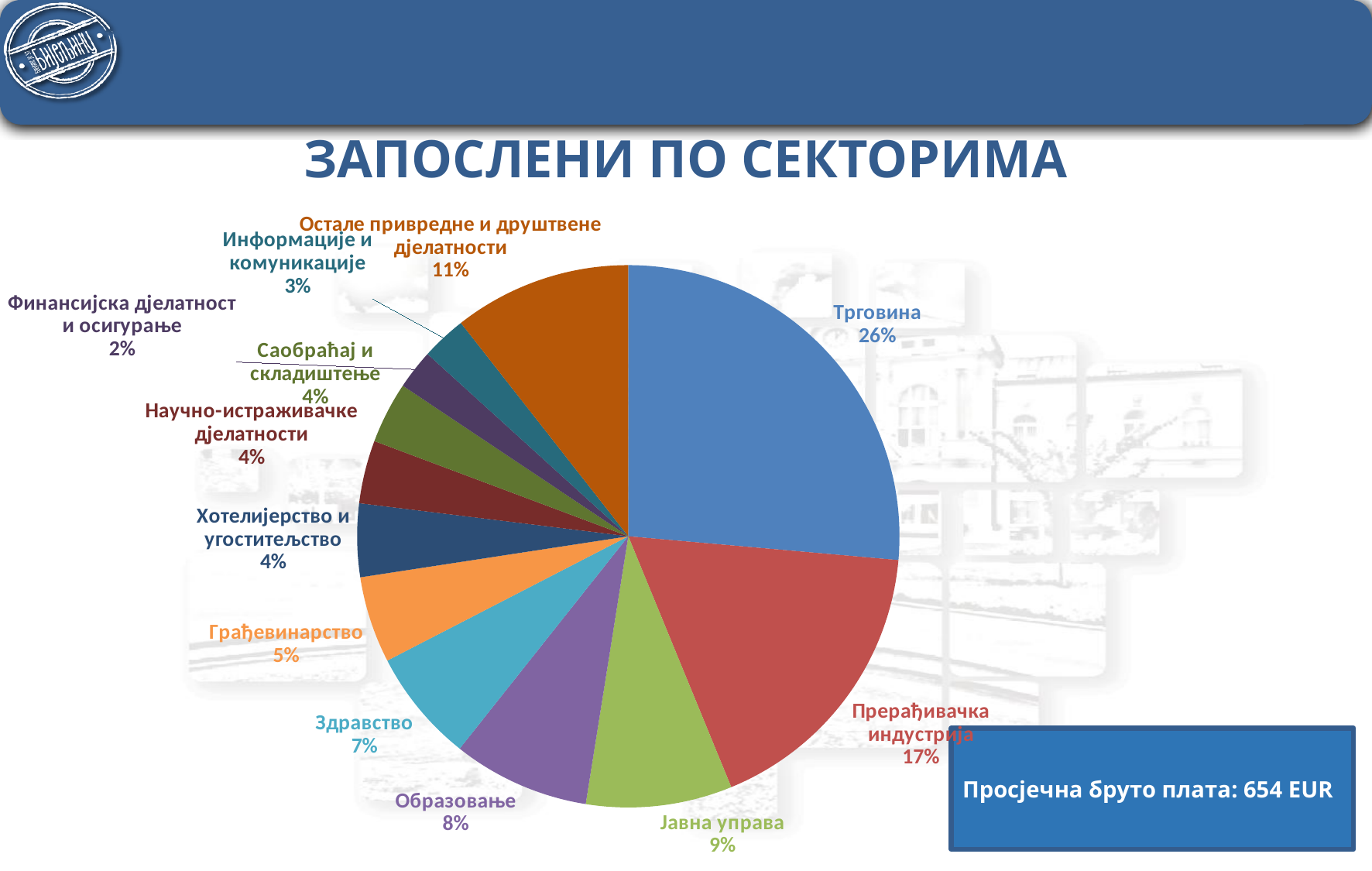
What share of employees is in Трговина? 26% Which has a larger share, Образовање or Јавна управа? Јавна управа What is the title of the chart? ЗАПОСЛЕНИ ПО СЕКТОРИМА Which sector has the smallest share of employees? Финансијска дјелатност и осигурање What share of employees is in Здравство? 7% What kind of chart is shown on the slide? pie chart What share of employees is in Остале привредне и друштвене дјелатности? 11% How many sectors are shown in the pie chart? 12 What share of employees is in Прерађивачка индустрија? 17% What is the combined share of Образовање and Здравство? 15% What is the difference in percentage points between Трговина and Прерађивачка индустрија? 9 Which sector has the largest share of employees? Трговина